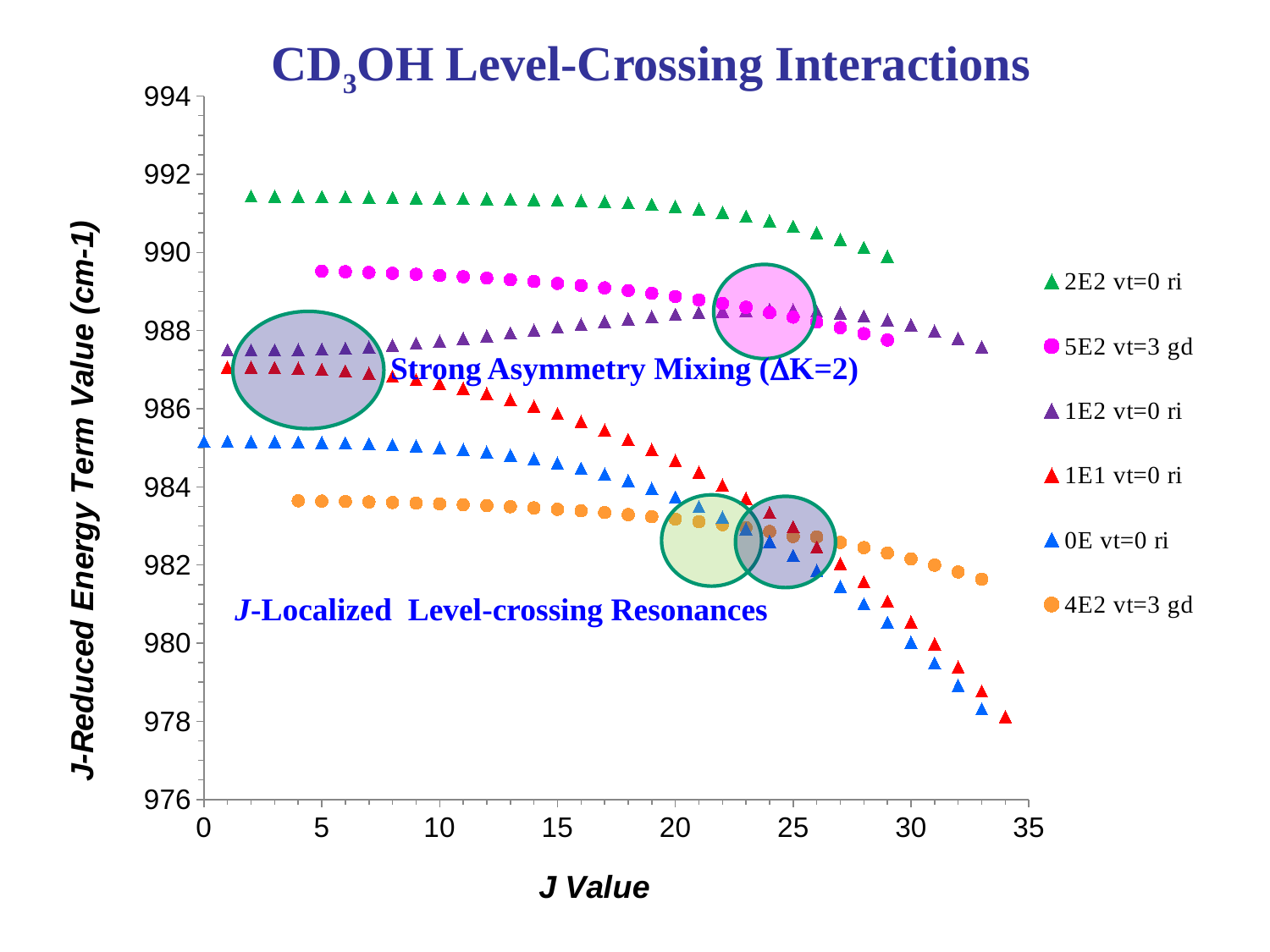
Which series has the highest J-reduced energy term values across the chart? 2E2 vt=0 ri Is the value for 0E vt=0 ri at J = 0 greater or less than 986? less Is the value for 2E2 vt=0 ri at J = 5 greater or less than 990? greater Is the value for 1E1 vt=0 ri at J = 30 greater or less than 982? less How many series does the legend list? 6 What is the label on the x axis of the chart? J Value What is the title of the chart? CD3OH Level-Crossing Interactions What kind of chart is shown on the slide? scatter chart At J = 10, which series has the lowest J-reduced energy term value? 4E2 vt=3 gd At J = 15, which series has the larger value: 1E1 vt=0 ri or 0E vt=0 ri? 1E1 vt=0 ri Do the values for 2E2 vt=0 ri rise or fall as J increases? fall